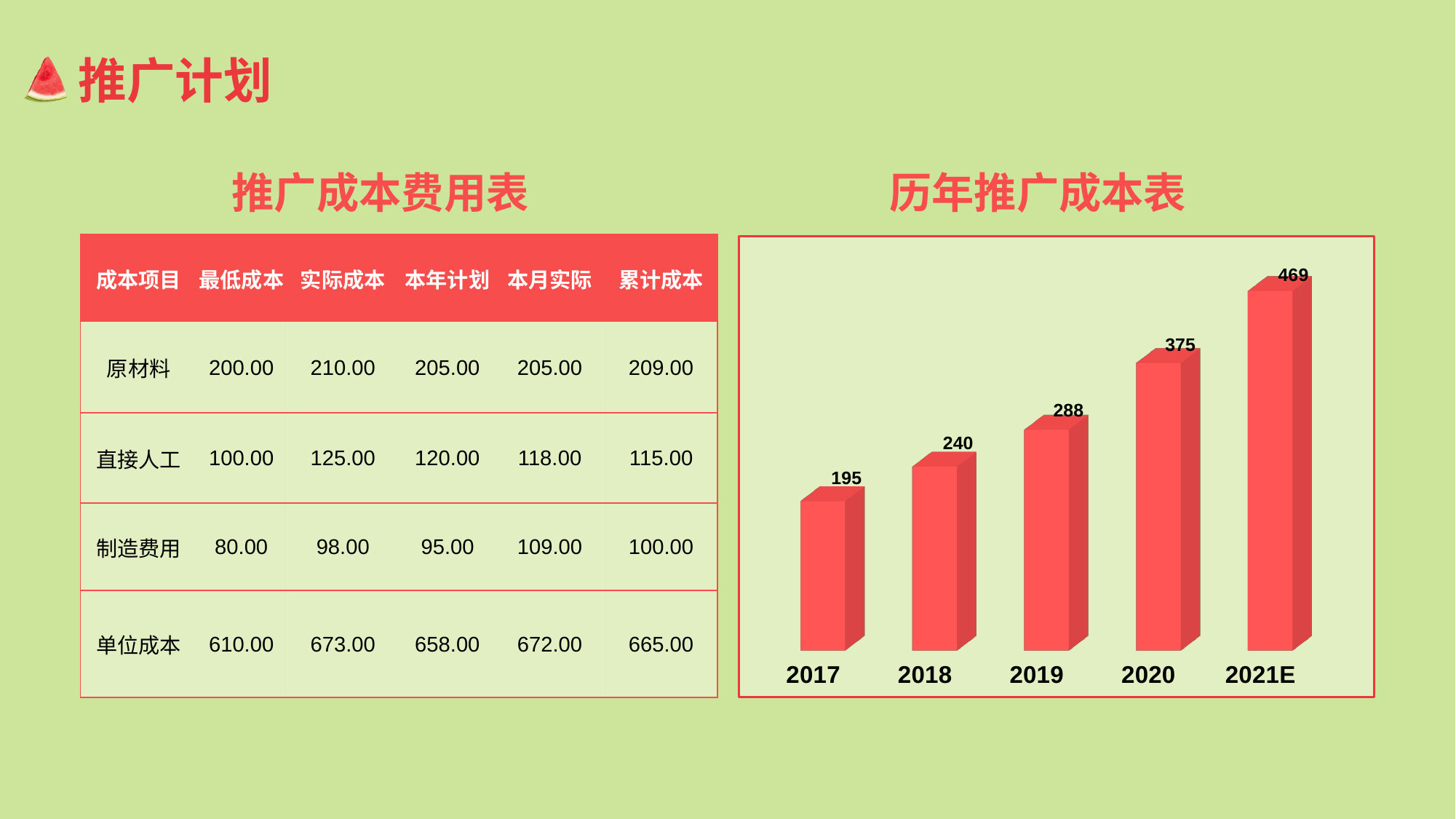
In the 历年推广成本表 chart, what is the difference between the values for 2021E and 2017? 274 In the 历年推广成本表 chart, what is the difference between the values for 2020 and 2019? 87 How many bars are shown in the 历年推广成本表 chart? 5 In the 历年推广成本表 chart, which year has the highest value? 2021E In the 历年推广成本表 chart, what is the value for 2019? 288 In the 历年推广成本表 chart, which is larger, the value for 2018 or the value for 2020? 2020 What kind of chart is the 历年推广成本表 chart? bar chart In the 历年推广成本表 chart, which year has the lowest value? 2017 In the 历年推广成本表 chart, what is the value for 2021E? 469 In the 历年推广成本表 chart, what is the value for 2017? 195 What is the title of the chart on the right side of the slide? 历年推广成本表 In the 历年推广成本表 chart, do the values rise or fall from 2017 to 2021E? rise